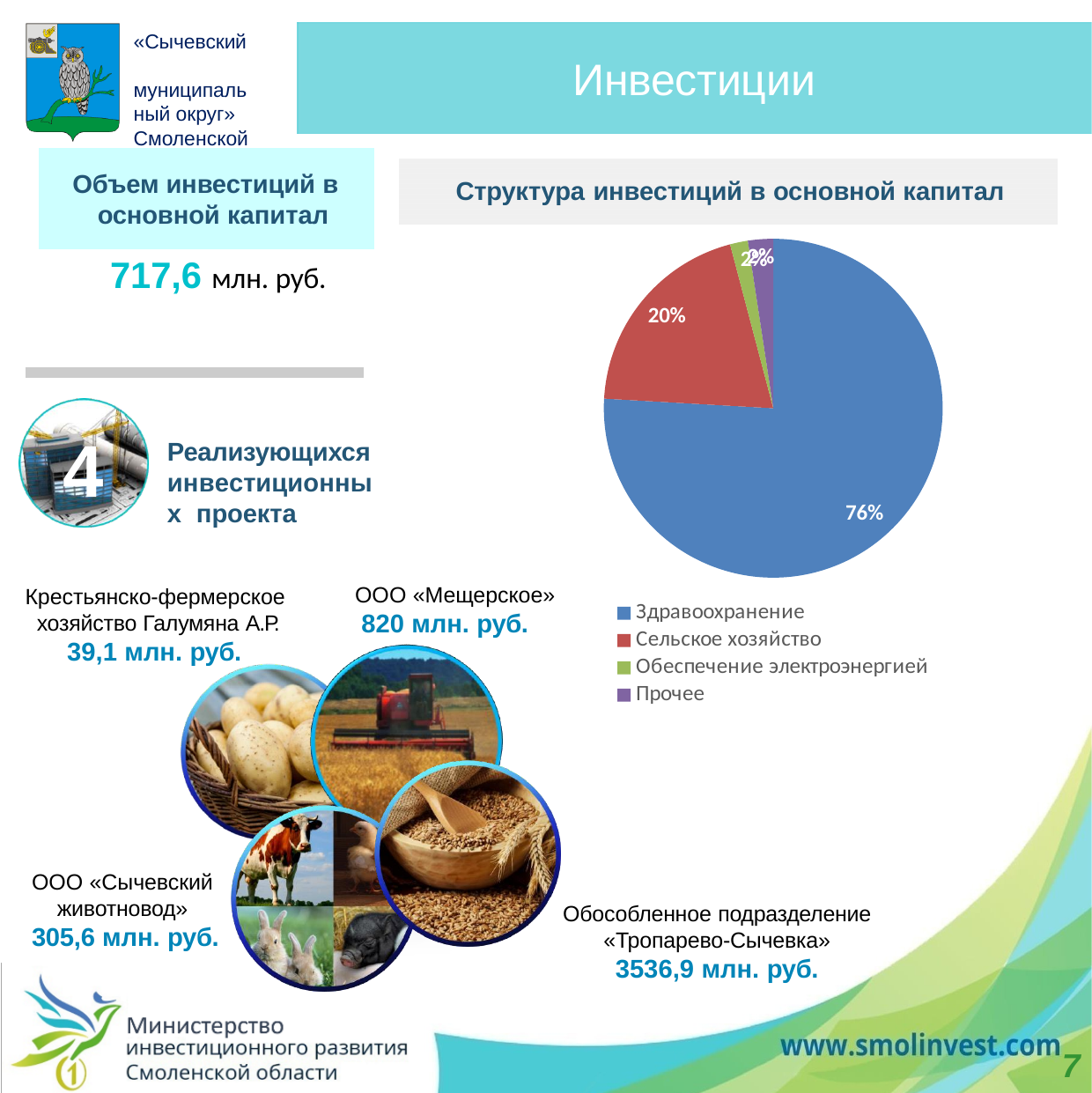
Is the share for «Сельское хозяйство» greater or less than 25%? less What colour is the «Здравоохранение» slice in the pie chart? blue What share of the pie chart does «Сельское хозяйство» account for? 20% What kind of chart is shown under the title «Структура инвестиций в основной капитал»? pie chart Which slice is larger in the pie chart: «Сельское хозяйство» or «Обеспечение электроэнергией»? Сельское хозяйство Which category has the largest slice in the pie chart? Здравоохранение How many categories does the legend of the pie chart list? 4 By how many percentage points does the «Здравоохранение» slice exceed the «Сельское хозяйство» slice? 56 What share of the pie chart does «Здравоохранение» account for? 76% What is the title of the pie chart on the slide? Структура инвестиций в основной капитал Is the share for «Здравоохранение» greater or less than 50%? greater